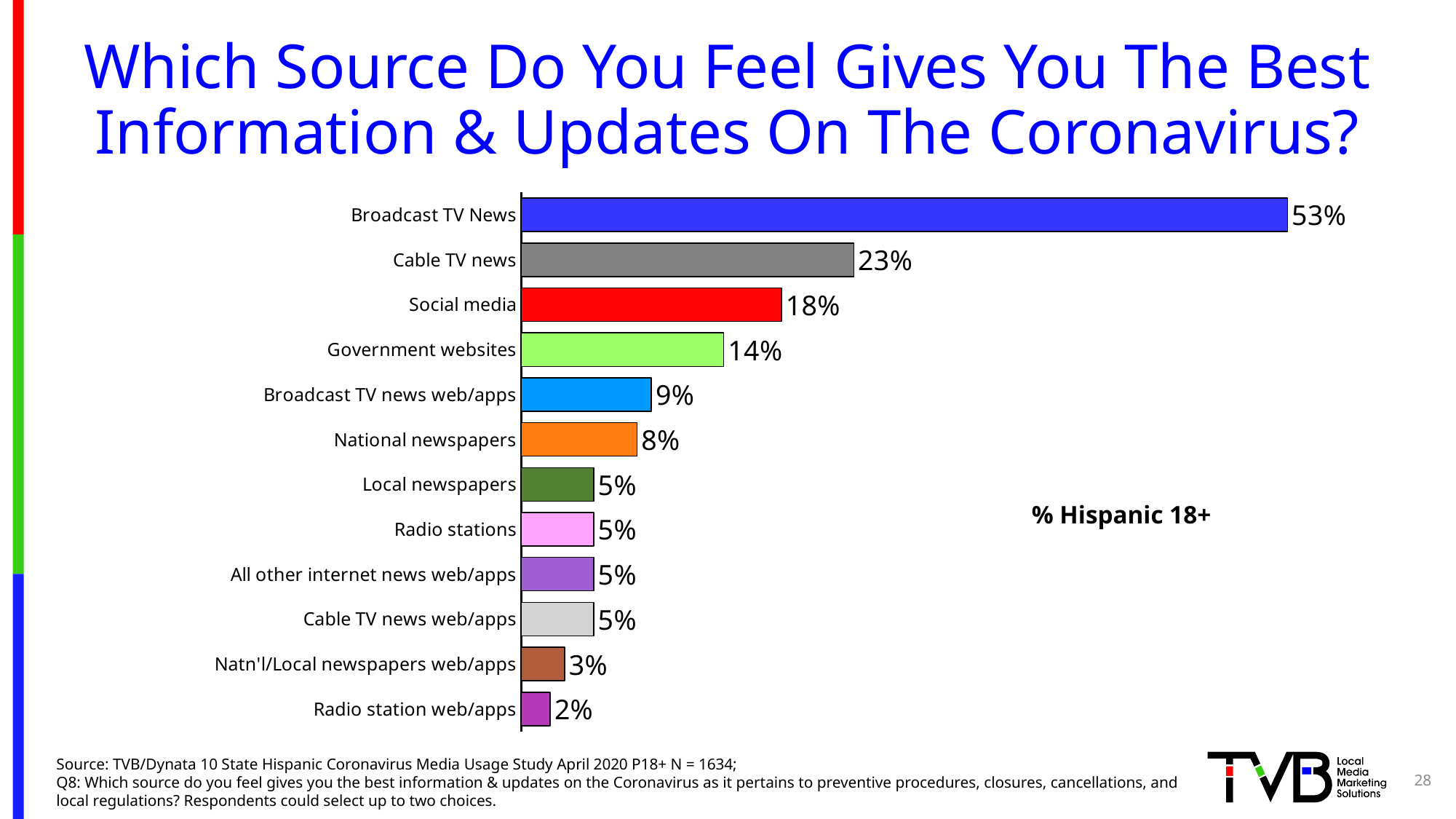
What is the difference in percentage points between Broadcast TV News and Cable TV news? 30 What percentage is shown for Natn'l/Local newspapers web/apps? 3% What is the value shown for Government websites? 14% Which source has the highest percentage on the chart? Broadcast TV News What audience label is shown next to the chart? % Hispanic 18+ What percentage of Hispanic adults 18+ chose Broadcast TV News as the source giving the best coronavirus information? 53% Which source has the lowest percentage on the chart? Radio station web/apps Which has a higher value, Broadcast TV news web/apps or National newspapers? Broadcast TV news web/apps How many sources (categories) are shown on the chart? 12 What is the difference in percentage points between Social media and Government websites? 4 What type of chart is shown on the slide? Bar chart Which has a higher value, Cable TV news or Social media? Cable TV news